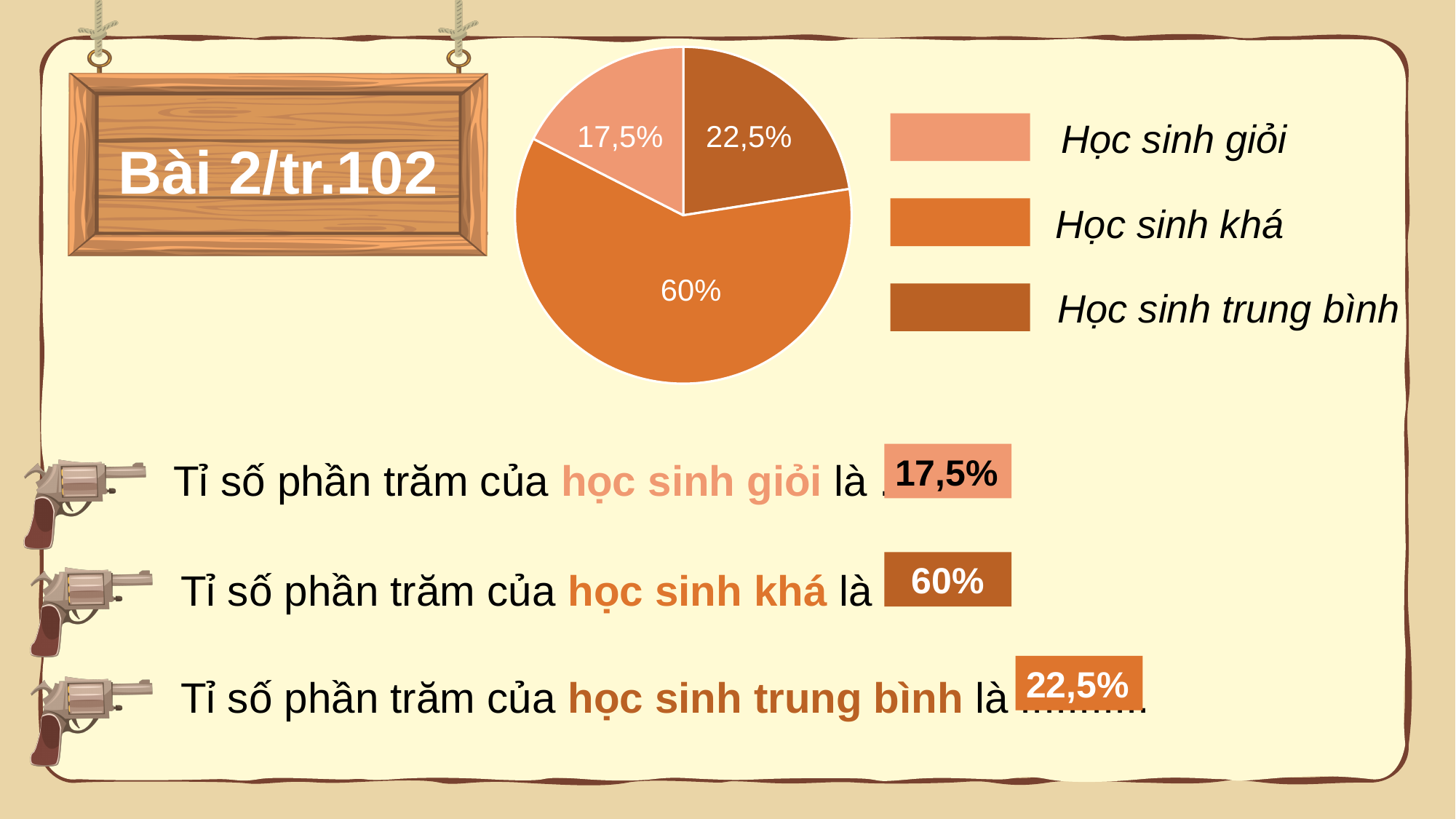
What percentage of the pie chart is labelled for Học sinh giỏi? 17,5% How many entries does the legend of the pie chart list? 3 What percentage of the pie chart is labelled for Học sinh khá? 60% What kind of chart is shown on the slide? pie chart Which category has the largest slice of the pie chart? Học sinh khá How many slices does the pie chart have? 3 What is the difference in percentage points between Học sinh khá and Học sinh trung bình in the pie chart? 37,5% Which category has the smallest slice of the pie chart? Học sinh giỏi Which legend entry is shown with the darkest brown colour in the pie chart? Học sinh trung bình What percentage of the pie chart is labelled for Học sinh trung bình? 22,5% Which is larger in the pie chart, Học sinh trung bình or Học sinh giỏi? Học sinh trung bình What is the difference in percentage points between Học sinh trung bình and Học sinh giỏi in the pie chart? 5%